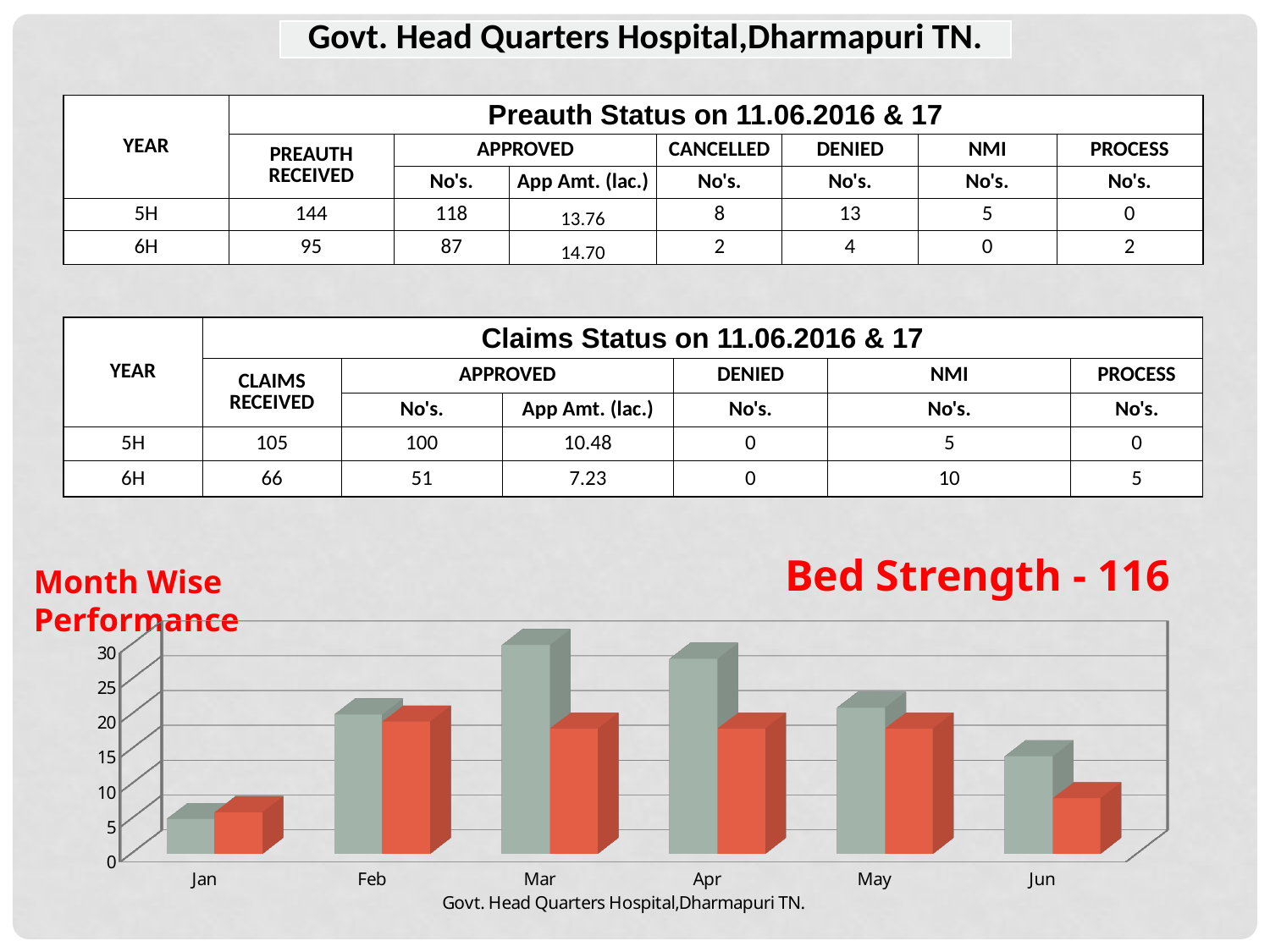
What text appears below the x axis of the chart? Govt. Head Quarters Hospital,Dharmapuri TN. Is the grey bar for Jan greater or less than 10? less In which month is the grey bar the tallest? Mar What kind of chart is shown at the bottom of the slide? bar chart In which month is the red bar the shortest? Jan In Mar, which bar is taller, the grey bar or the red bar? the grey bar Is the red bar for Jun greater or less than 15? less In which month is the grey bar the shortest? Jan How many months are shown on the x axis of the chart? 6 Is the grey bar for Mar greater or less than 25? greater Which is taller, the grey bar for Jan or the grey bar for Jun? Jun